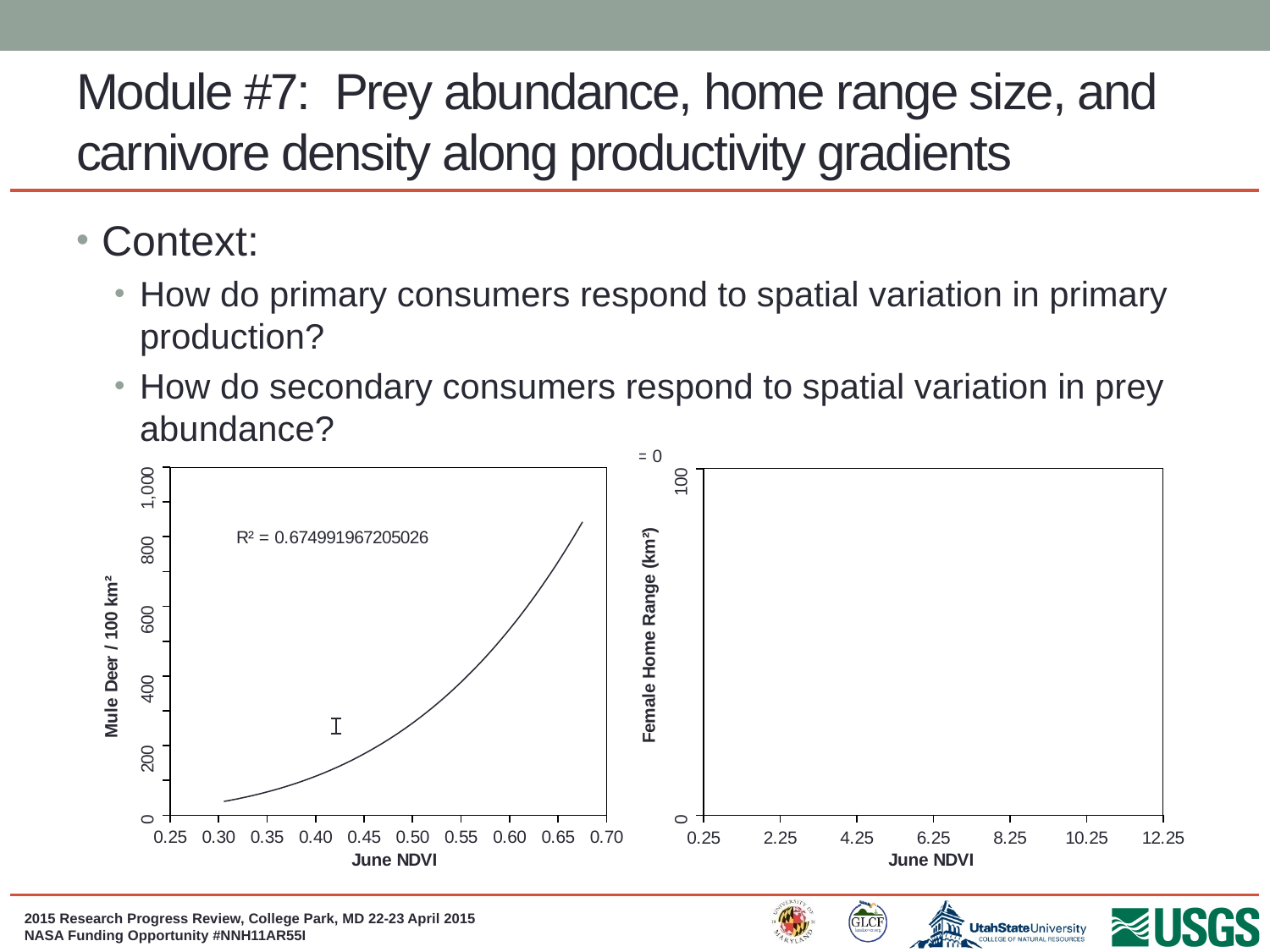
On the left chart, what is the highest tick value shown on the y axis? 1,000 On the left chart, what is the label of the y axis? Mule Deer / 100 km² On the left chart, what is the label of the x axis? June NDVI On the left chart, is the value of the curve at June NDVI 0.35 greater or less than 200? less On the left chart, is the value of the curve at June NDVI 0.50 greater or less than 600? less On the left chart, is the value of the curve at June NDVI 0.65 greater or less than 600? greater On the right chart, what is the highest tick value shown on the x axis? 12.25 How many charts are shown on the slide? 2 On the left chart, what R² value is printed? R² = 0.674991967205026 On the right chart, what is the label of the y axis? Female Home Range (km²) On the left chart, what is the highest tick value shown on the x axis? 0.70 On the left chart, does the curve rise or fall as June NDVI increases? rises